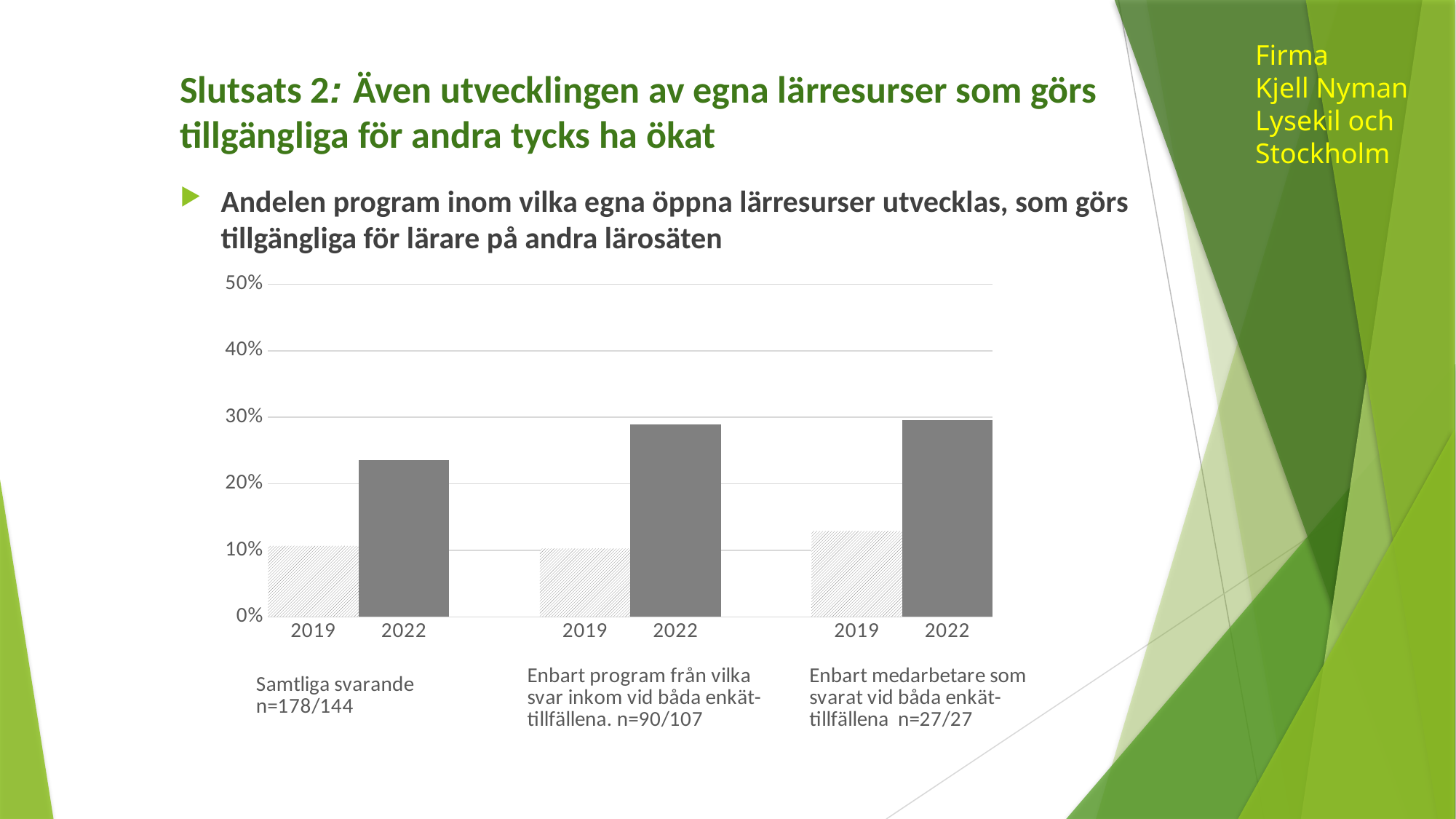
How many bars are plotted in the chart? 6 Is the value for 2022 in the 'Samtliga svarande' group greater or less than 30%? less Which is larger: the 2022 value for 'Samtliga svarande' or the 2022 value for 'Enbart program från vilka svar inkom vid båda enkättillfällena'? Enbart program från vilka svar inkom vid båda enkättillfällena Is the value for 2019 in the 'Enbart medarbetare som svarat vid båda enkättillfällena' group greater or less than 20%? less Do the values rise or fall from 2019 to 2022 in each group of the chart? rise How many groups of respondents are shown along the x axis of the chart? 3 Is the value for 2022 in the 'Samtliga svarande' group greater or less than 20%? greater Within the 'Samtliga svarande' group, which year has the higher value, 2019 or 2022? 2022 What is the highest value shown on the y axis of the chart? 50% What kind of chart is shown on the slide? bar chart